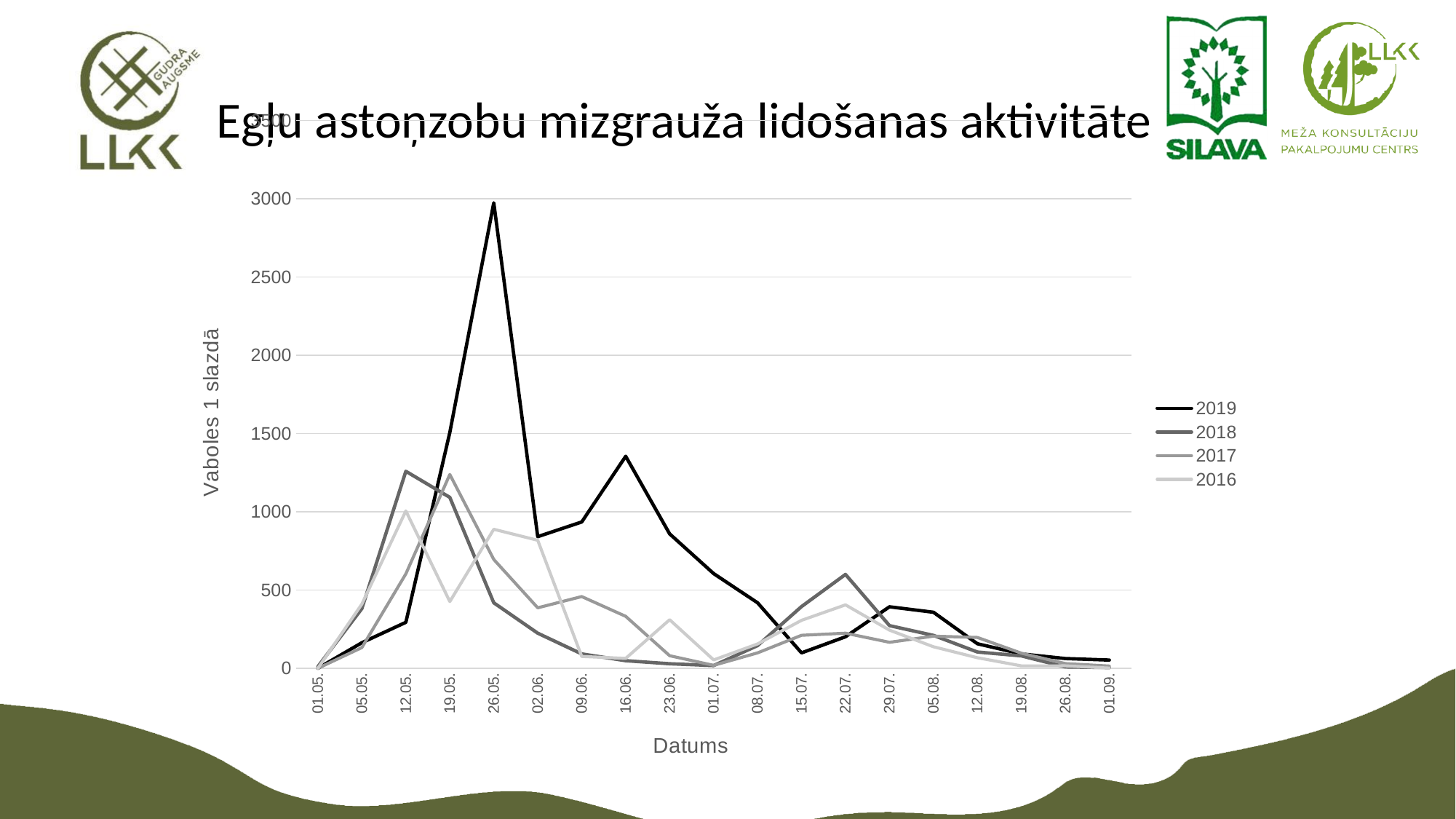
How many series does the legend list? 4 On which date does the 2019 series reach its highest value? 26.05. What is the label of the y axis? Vaboles 1 slazdā Is the value for 2019 on 15.07. greater or less than 500? less How many dates are marked along the x axis? 19 Which series reaches the highest peak on the chart? 2019 On 12.05., which series has the larger value, 2018 or 2019? 2018 Is the value for 2016 on 19.05. greater or less than 500? less Does the 2019 series rise or fall between 16.06. and 01.07.? fall Is the value for 2019 on 26.05. greater or less than 2500? greater What kind of chart is shown on the slide? line chart